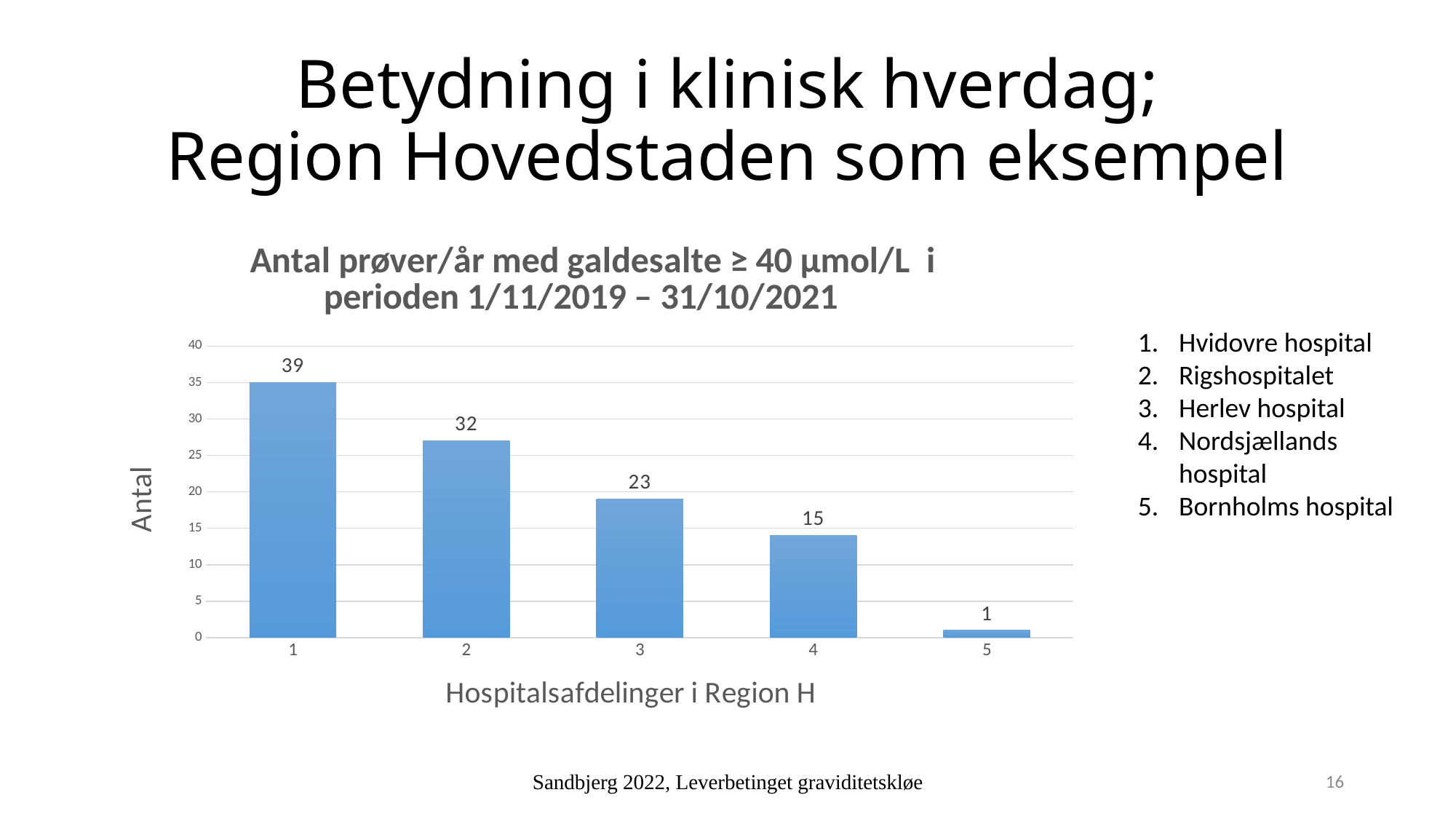
What is the value for category 1 in the chart? 39 Do the values rise or fall from category 1 to category 5? fall What kind of chart is shown on the slide? bar chart What is the difference between the values for category 1 and category 2? 7 Which is larger, the value for category 2 or the value for category 4? 2 Which category has the lowest value in the chart? 5 How many categories are shown on the x axis of the chart? 5 What is the value for category 5 in the chart? 1 Is the value for category 1 greater or less than 30? greater Which category has the highest value in the chart? 1 What is the value for category 3 in the chart? 23 What is the difference between the values for category 3 and category 4? 8